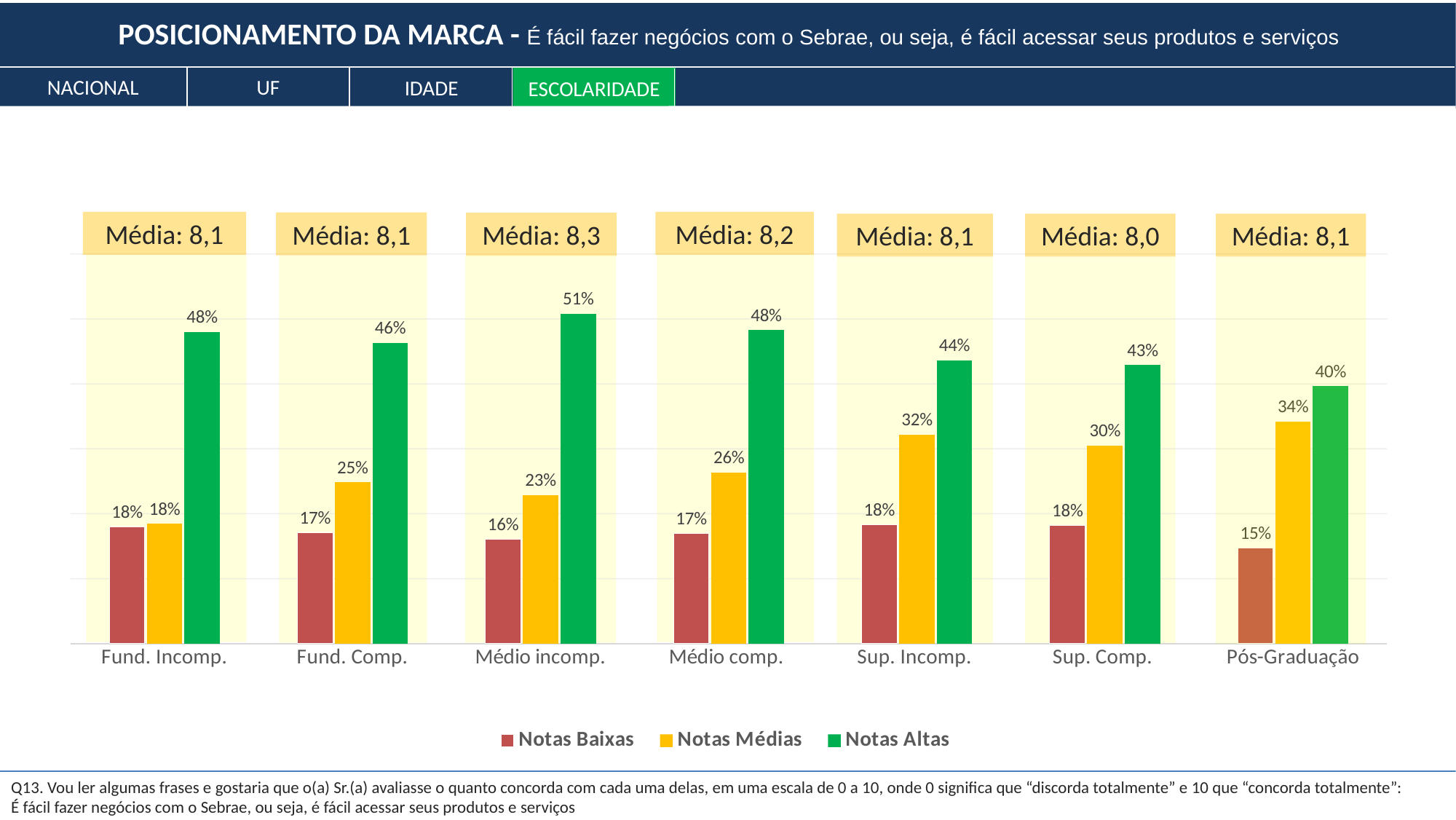
What is the value of Notas Baixas for Fund. Comp.? 17% Which is larger for Sup. Incomp.: Notas Médias or Notas Baixas? Notas Médias What is the difference between Notas Altas and Notas Médias for Sup. Comp.? 13% What is the value of Notas Médias for Pós-Graduação? 34% Which category has the highest Notas Altas value? Médio incomp. What kind of chart is shown on the slide? Bar chart Which category has the lowest Notas Baixas value? Pós-Graduação What is the Média shown above the Médio incomp. category? 8,3 Which tab is highlighted in green at the top of the slide? ESCOLARIDADE How many education categories are shown on the x axis? 7 How many series does the legend list? 3 What is the value of Notas Altas for Médio incomp.? 51%